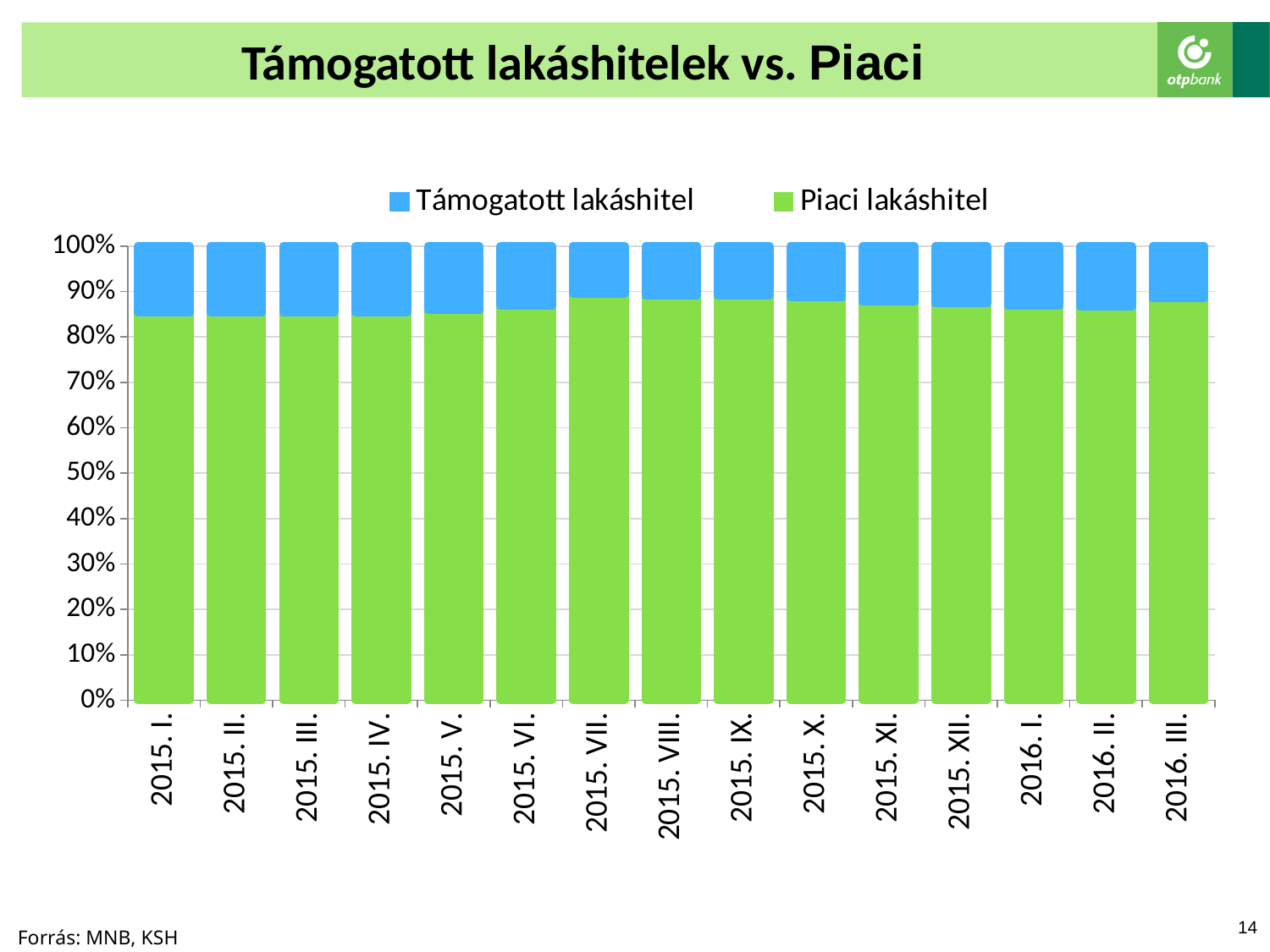
How many series does the legend list? 2 How many months (categories) are shown on the x axis? 15 Is the value for Piaci lakáshitel in 2015. I. greater or less than 80%? greater What kind of chart is shown on the slide? stacked bar chart What is the title of the slide containing the chart? Támogatott lakáshitelek vs. Piaci Which series is shown in green? Piaci lakáshitel What is the first category on the x axis? 2015. I. Which is larger, the Támogatott lakáshitel share in 2015. I. or in 2015. VII.? 2015. I. What is the total height of the stacked bar for 2015. I.? 100% Is the value for Piaci lakáshitel in 2016. III. greater or less than 80%? greater Is the value for Támogatott lakáshitel in 2015. I. greater or less than 20%? less